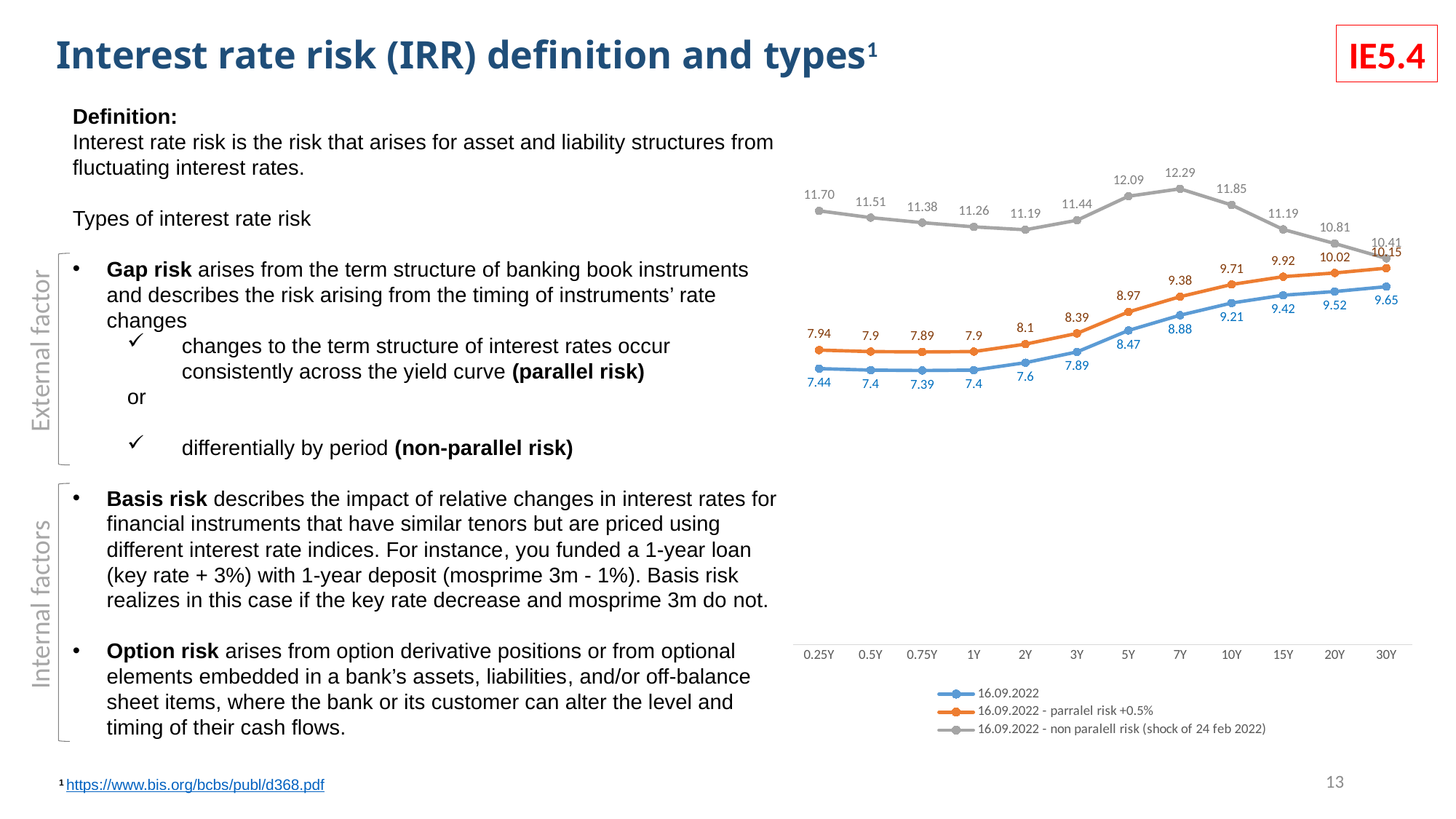
What is the value of the 16.09.2022 - parralel risk +0.5% series at 30Y? 10.15 How many tenor points are plotted along the x axis of the chart? 12 Does the 16.09.2022 series rise or fall between 2Y and 30Y? Rise At which tenor does the 16.09.2022 series have its lowest value? 0.75Y How many series does the chart legend list? 3 Which series has the higher value at 30Y: 16.09.2022 - non paralell risk (shock of 24 feb 2022) or 16.09.2022? 16.09.2022 - non paralell risk (shock of 24 feb 2022) What is the value of the 16.09.2022 - non paralell risk (shock of 24 feb 2022) series at 7Y? 12.29 What colour is the line for the 16.09.2022 - parralel risk +0.5% series? Orange What type of chart is shown on the slide? Line chart At which tenor does the 16.09.2022 - non paralell risk (shock of 24 feb 2022) series reach its highest value? 7Y What is the difference between the 16.09.2022 - parralel risk +0.5% value and the 16.09.2022 value at 0.25Y? 0.5 What is the value of the 16.09.2022 series at 5Y? 8.47